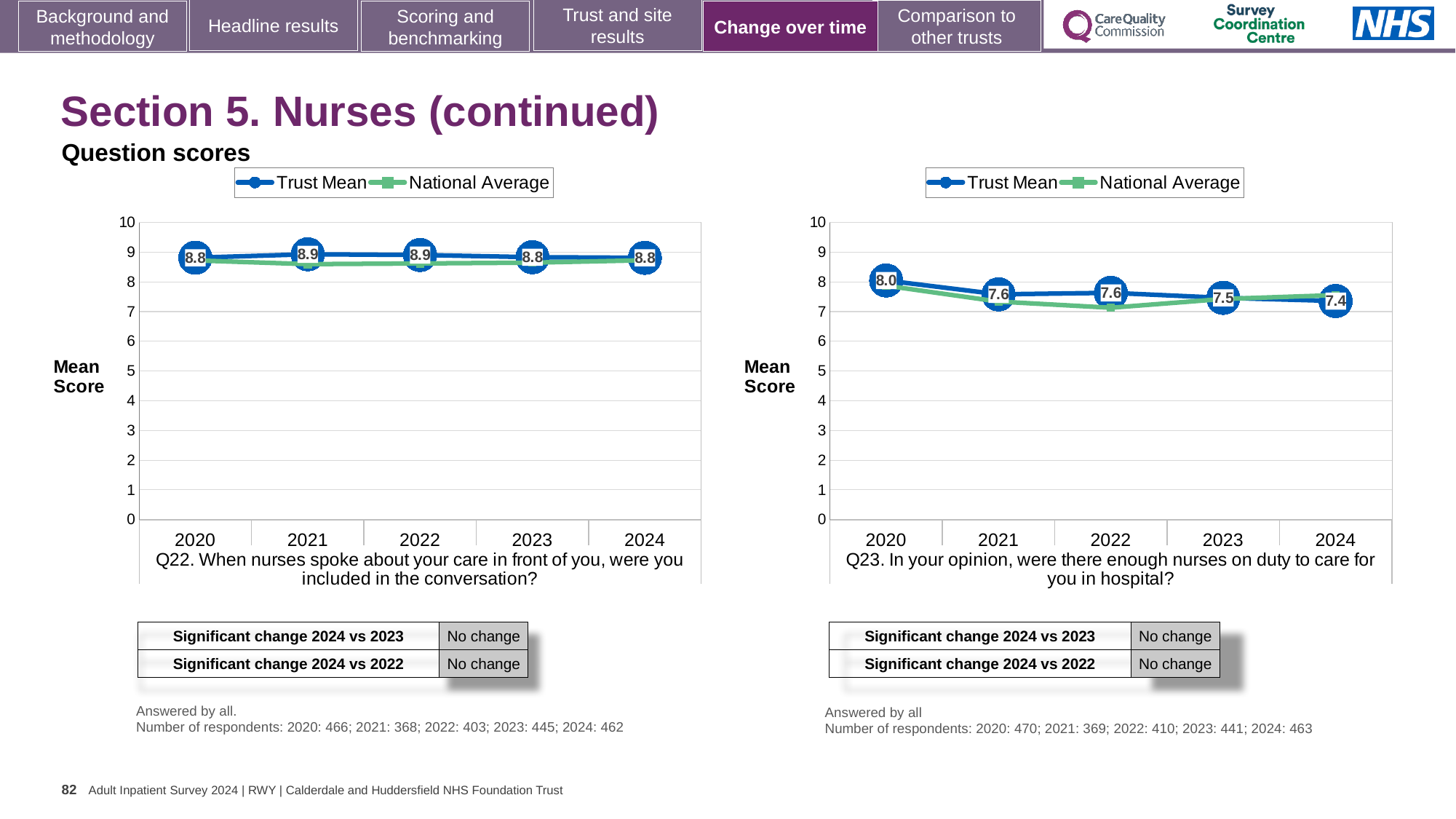
On the Q22 chart, what is the Trust Mean score for 2024? 8.8 On the Q22 chart, is the Trust Mean score for 2020 greater or less than 8? greater On the Q23 chart, which year has the highest Trust Mean score? 2020 On the Q23 chart, what is the Trust Mean score for 2020? 8.0 On the Q22 chart, what is the Trust Mean score for 2021? 8.9 On the Q23 chart, what is the Trust Mean score for 2024? 7.4 On the Q23 chart, what is the difference between the Trust Mean scores for 2020 and 2024? 0.6 On the Q23 chart, is the National Average for 2022 greater or less than 8? less On the Q23 chart, which year has the lowest Trust Mean score? 2024 What kind of chart is the Q23 chart? Line chart How many years are shown on the x axis of the Q22 chart? 5 How many series does the legend of the Q23 chart list? 2